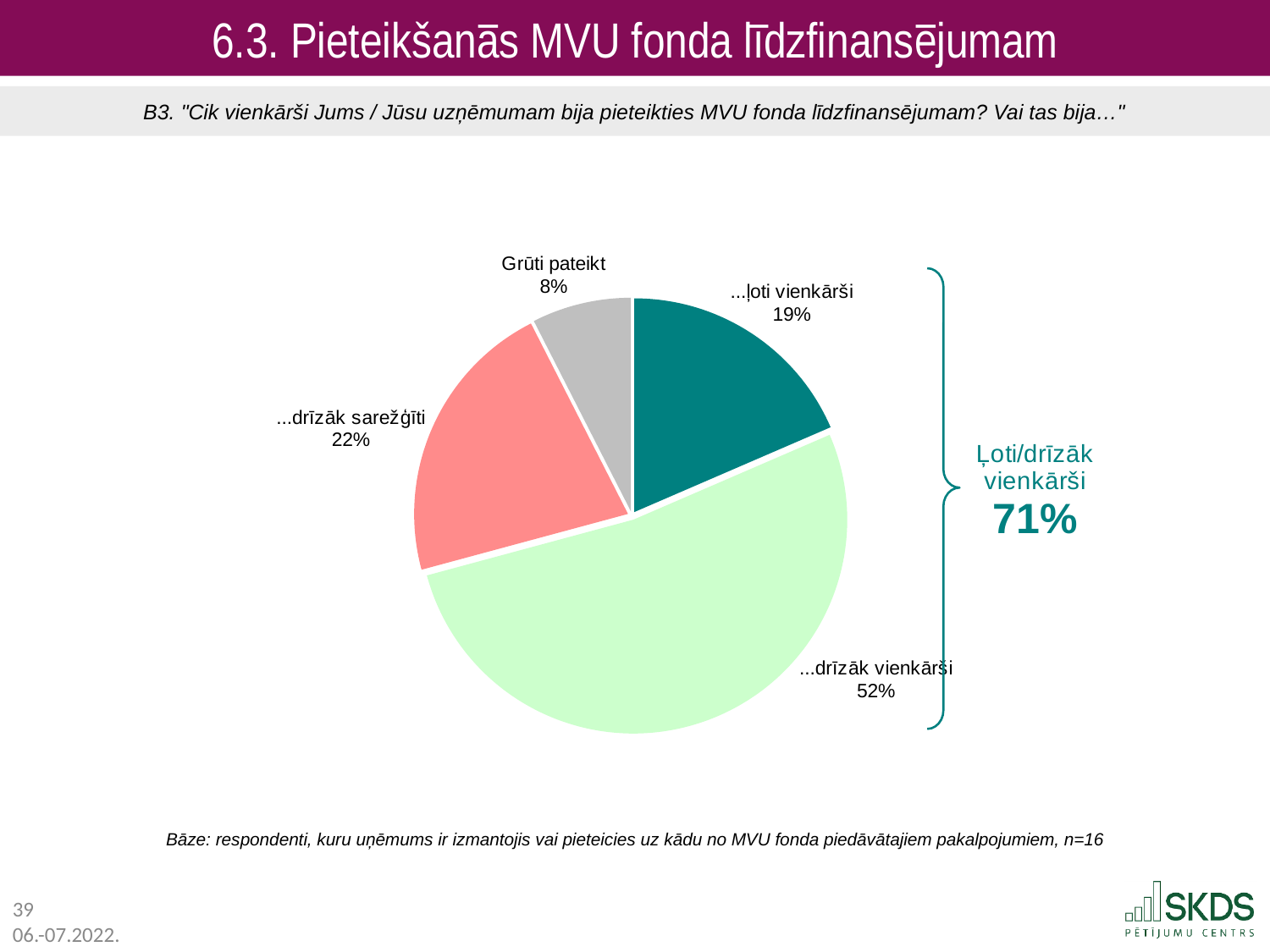
What kind of chart is shown on the slide? pie chart What colour is the "Grūti pateikt" slice? grey Which category has the smallest slice of the pie? Grūti pateikt What is the value for "...drīzāk vienkārši"? 52% What is the value for "Grūti pateikt"? 8% Which category has the largest slice of the pie? ...drīzāk vienkārši Which is larger, the value for "...drīzāk sarežģīti" or the value for "...ļoti vienkārši"? ...drīzāk sarežģīti What combined share is shown for "Ļoti/drīzāk vienkārši" next to the bracket? 71% What is the difference between the values for "...drīzāk vienkārši" and "...drīzāk sarežģīti"? 30% How many slices does the pie chart have? 4 What is the value for "...drīzāk sarežģīti"? 22% What is the value for "...ļoti vienkārši"? 19%